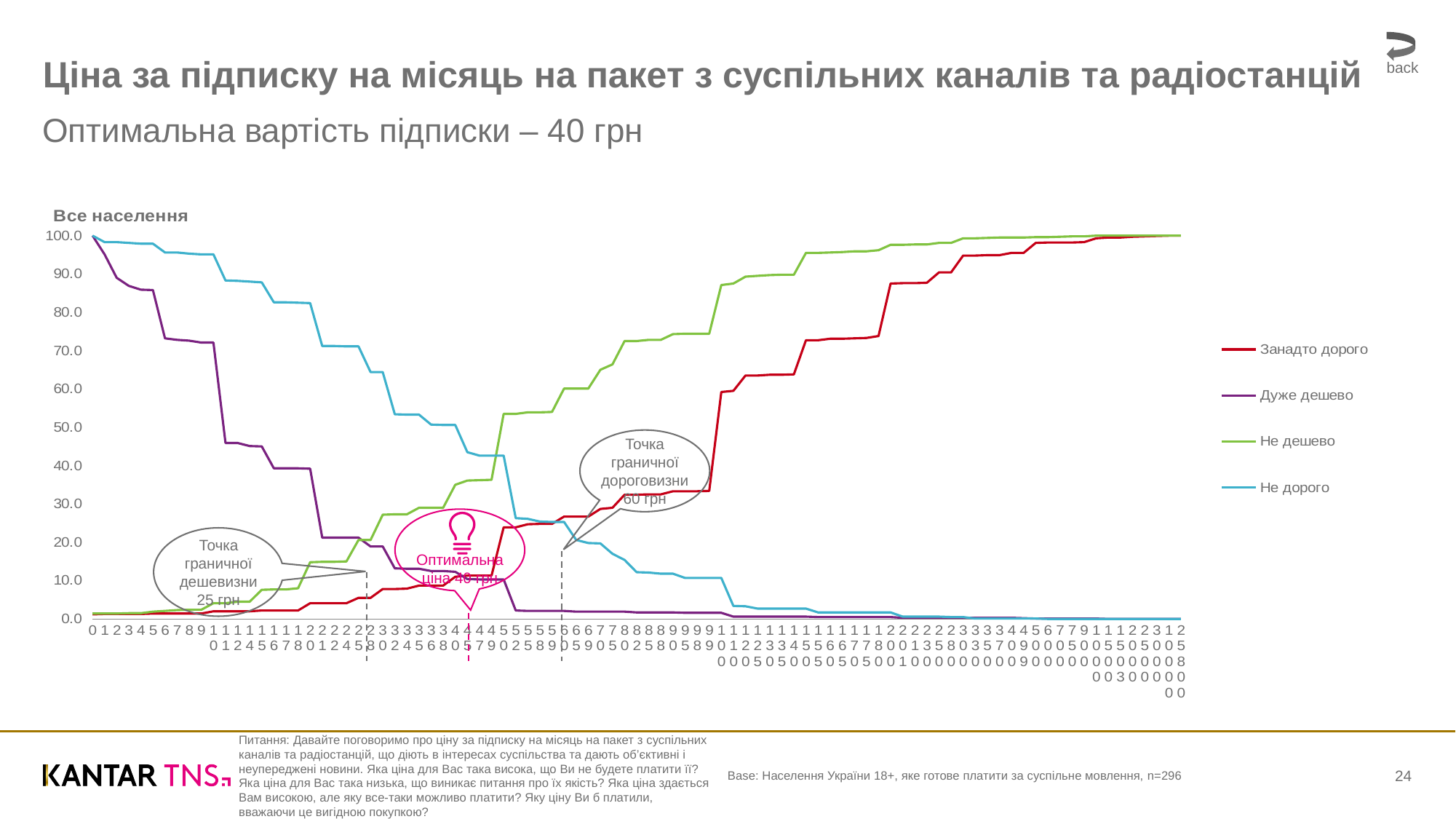
At price 0, which is larger: Дуже дешево or Не дешево? Дуже дешево Is the value for Не дорого at price 0 greater or less than 90? greater Does the Не дорого line rise or fall as the price increases along the x axis? falls Does the Занадто дорого line rise or fall as the price increases along the x axis? rises Is the value for Занадто дорого at price 0 greater or less than 10? less According to the annotation on the chart, what is the optimal price (Оптимальна ціна)? 40 грн Which series is drawn in red? Занадто дорого Does the Не дешево line rise or fall as the price increases along the x axis? rises How many series does the legend list? 4 At price 0, which is larger: Не дорого or Занадто дорого? Не дорого What kind of chart is shown on the slide? line chart